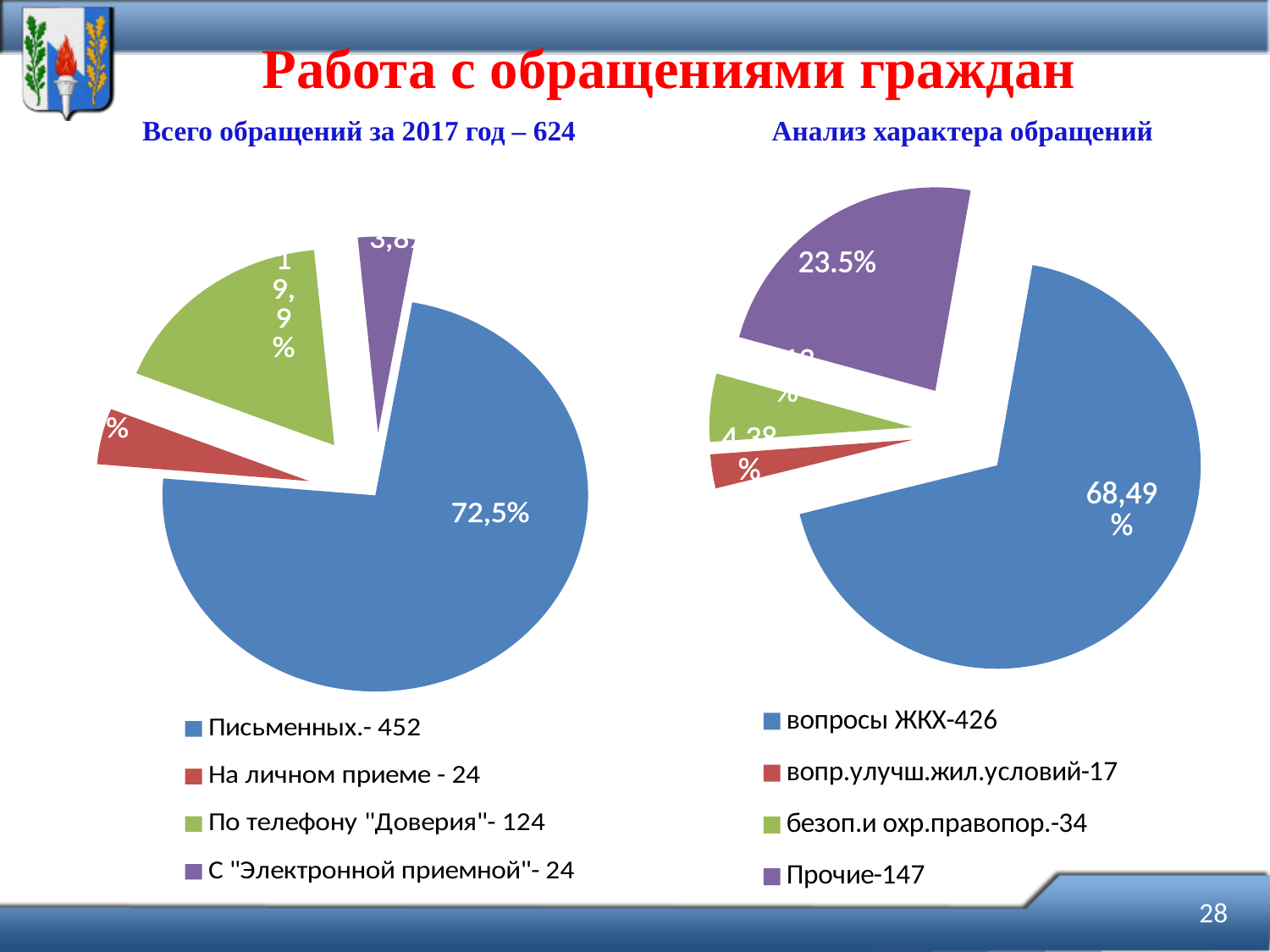
In the right chart ("Анализ характера обращений"), how many categories does the legend list? 4 In the left chart ("Всего обращений за 2017 год – 624"), what percentage is shown on the По телефону "Доверия" slice? 19,9% In the right chart ("Анализ характера обращений"), what percentage is shown on the Прочие slice? 23.5% In the left chart ("Всего обращений за 2017 год – 624"), which category has the largest slice? Письменных.- 452 In the left chart ("Всего обращений за 2017 год – 624"), how many slices does the pie have? 4 In the left chart ("Всего обращений за 2017 год – 624"), which is larger: На личном приеме or По телефону "Доверия"? По телефону "Доверия" What kind of chart is the right chart titled "Анализ характера обращений"? pie chart In the left chart ("Всего обращений за 2017 год – 624"), what percentage is shown on the Письменных slice? 72,5% In the right chart ("Анализ характера обращений"), which category has the largest slice? вопросы ЖКХ-426 What kind of chart is the left chart titled "Всего обращений за 2017 год – 624"? pie chart In the left chart ("Всего обращений за 2017 год – 624"), how many appeals does the legend give for По телефону "Доверия"? 124